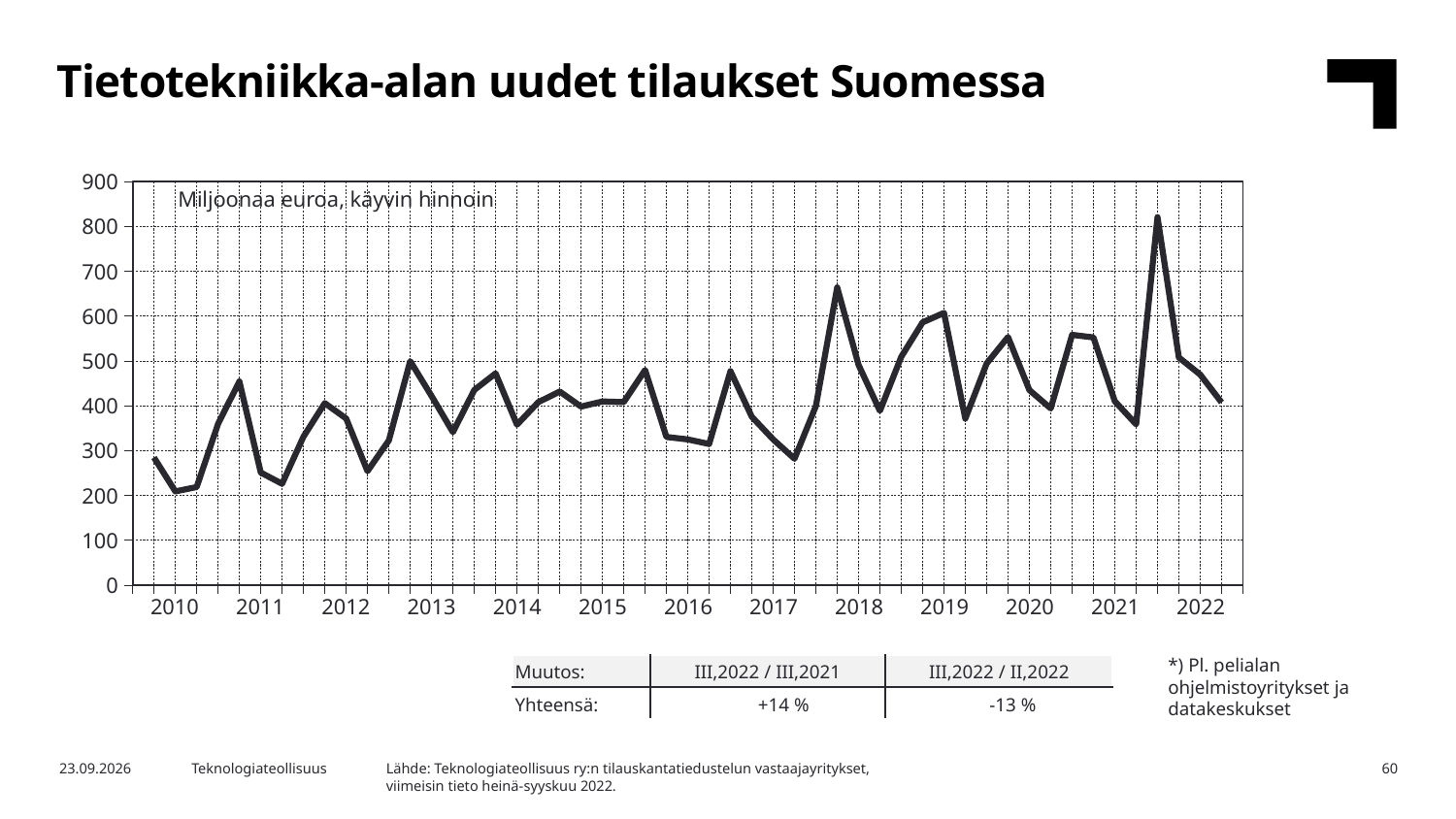
Is the highest peak of the line, in 2021, greater or less than 700? greater Does the line rise or fall from the 2021 peak to the last point in 2022? fall Is the lowest point of the line, in 2010, greater or less than 300? less In which year does the line reach its lowest point? 2010 According to the table below the chart, what is the change for III,2022 / III,2021? +14 % How many years are labelled on the x axis? 13 Is the peak value in 2018 greater or less than 600? greater In what unit are the values on the chart expressed, according to the label inside the plot area? Miljoonaa euroa, käyvin hinnoin In which year does the line reach its highest peak? 2021 What kind of chart is shown on the slide? line chart What is the title of the chart on the slide? Tietotekniikka-alan uudet tilaukset Suomessa